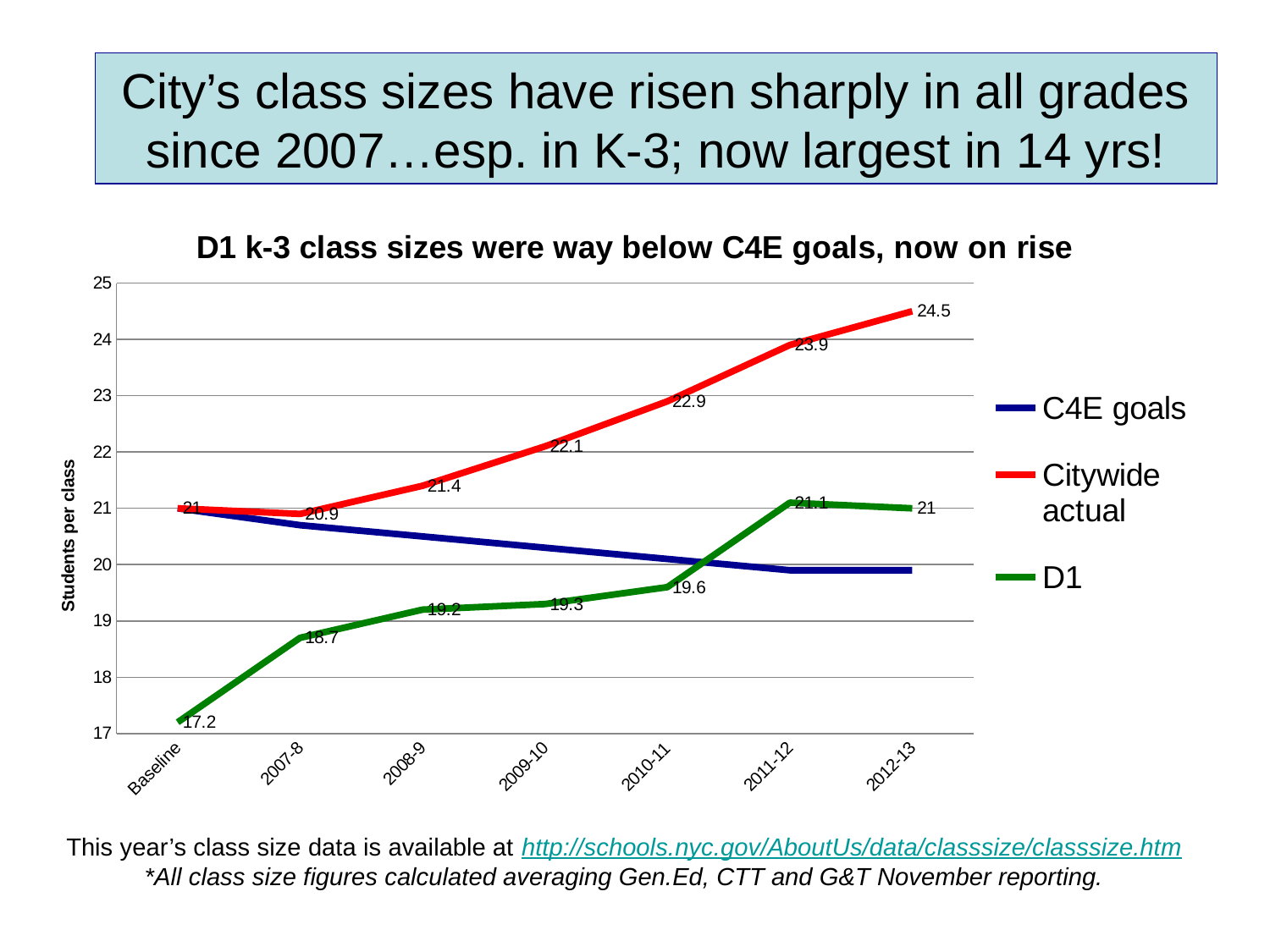
How many points are plotted along the x axis for each series? 7 Does the Citywide actual series rise or fall from 2007-8 to 2012-13? rise What is the difference between the Citywide actual value and the D1 value in 2012-13? 3.5 At which point is the D1 series lowest? Baseline What is the Citywide actual value for 2012-13? 24.5 What is the D1 value for 2007-8? 18.7 Which is larger in 2010-11, the Citywide actual value or the D1 value? Citywide actual What is the D1 value at Baseline? 17.2 What type of chart is shown on the slide? line chart In which year does the Citywide actual series reach its highest value? 2012-13 How many series does the legend list? 3 Is the C4E goals value for 2008-9 greater or less than 20? greater